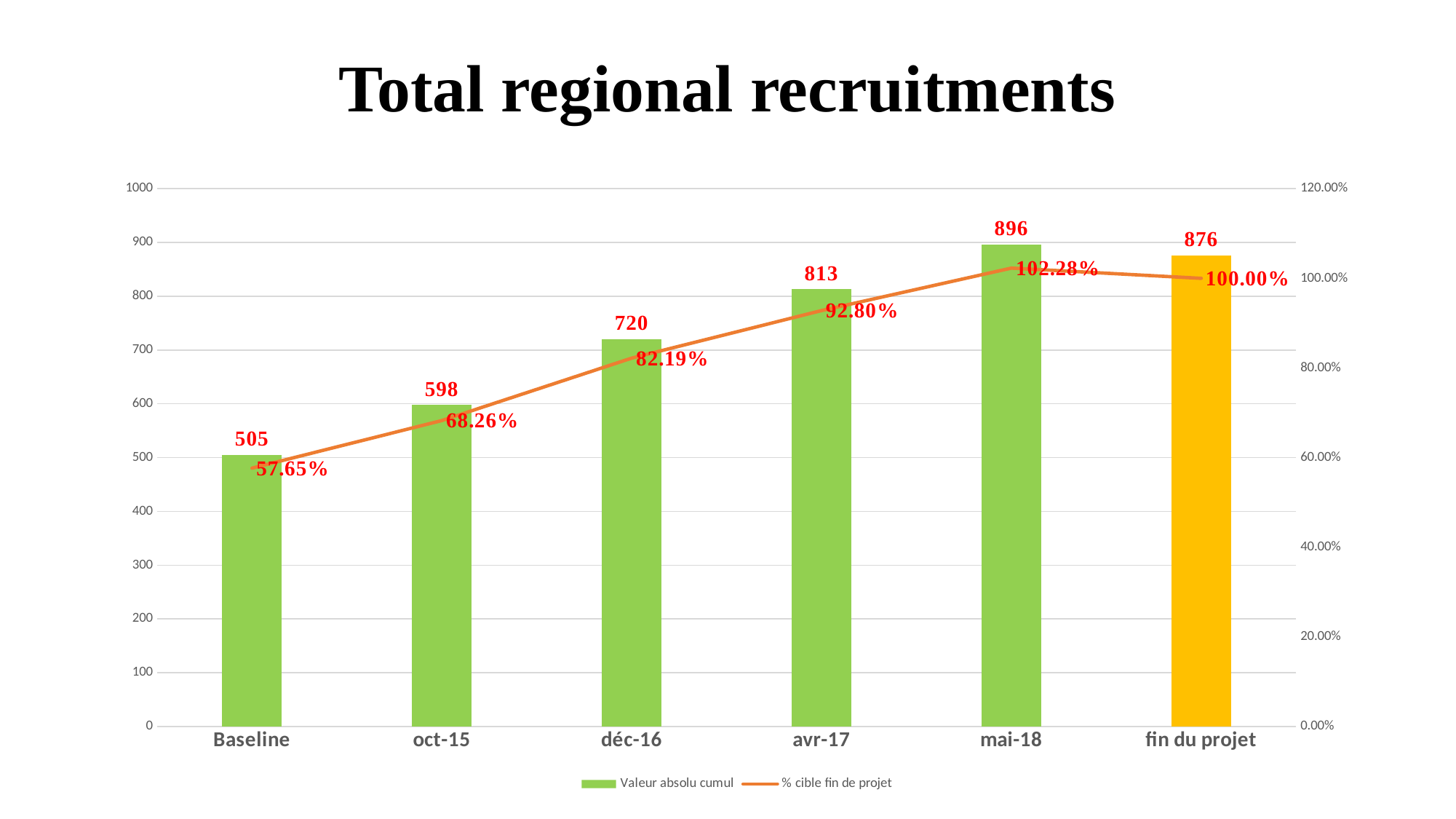
What is the difference between the 'Valeur absolu cumul' values for avr-17 and déc-16? 93 What is the '% cible fin de projet' value for Baseline? 57.65% What is the value of 'Valeur absolu cumul' for mai-18? 896 How many categories are shown on the x axis? 6 Which category has the lowest 'Valeur absolu cumul' value? Baseline Which is larger, the 'Valeur absolu cumul' value for mai-18 or for fin du projet? mai-18 What is the '% cible fin de projet' value for déc-16? 82.19% What is the value of 'Valeur absolu cumul' for oct-15? 598 What is the title of the chart? Total regional recruitments Which category has the highest 'Valeur absolu cumul' value? mai-18 Does the 'Valeur absolu cumul' value rise or fall from Baseline to mai-18? rise How many series does the legend list? 2